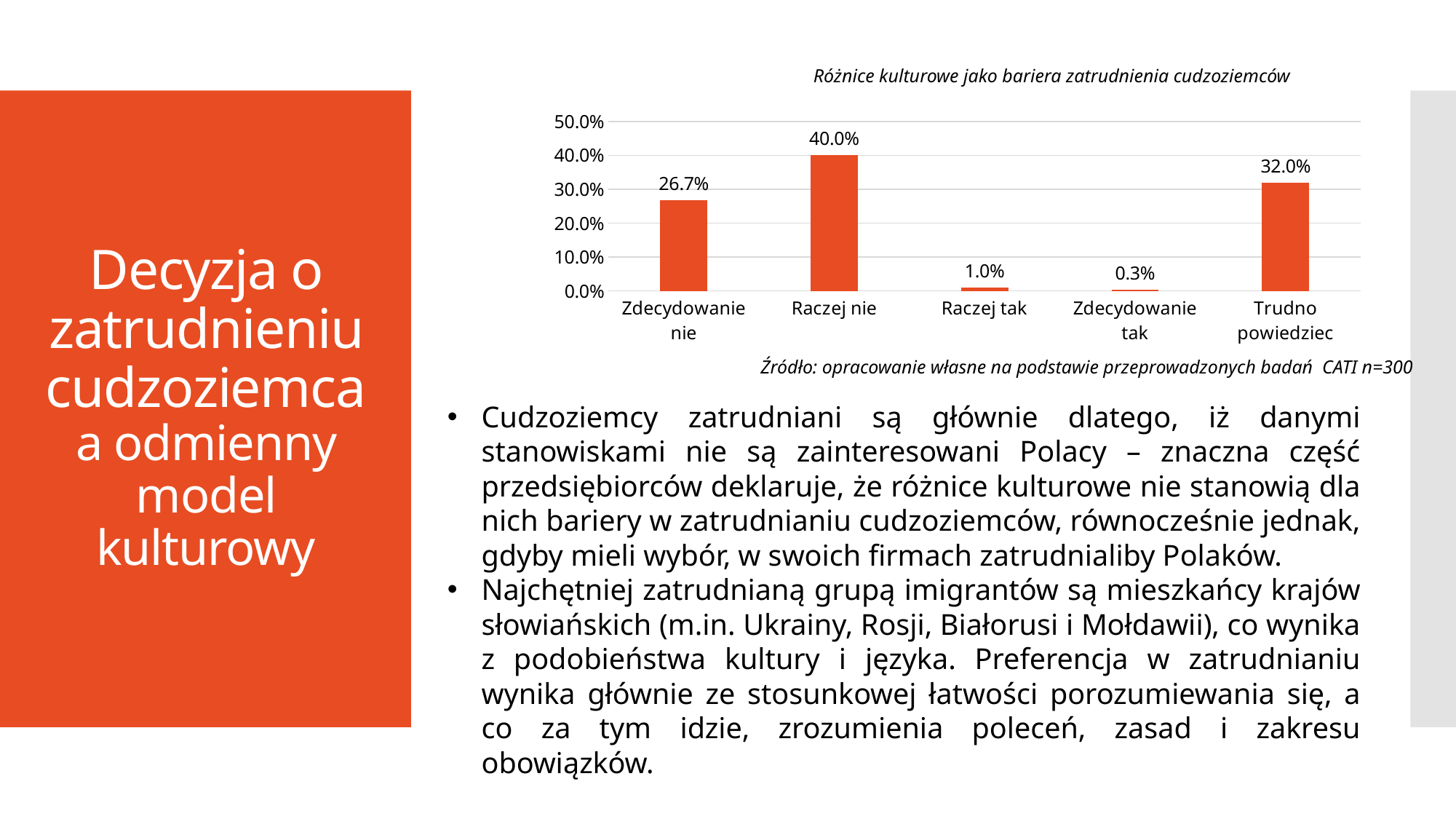
What is the value for "Zdecydowanie tak"? 0.3% What is the difference between the values for "Raczej nie" and "Trudno powiedziec"? 8.0% Which category has the highest value? Raczej nie How many categories are shown on the x axis? 5 Which category has the lowest value? Zdecydowanie tak What is the value for "Trudno powiedziec"? 32.0% What is the title of the chart? Różnice kulturowe jako bariera zatrudnienia cudzoziemców Is the value for "Raczej nie" greater or less than 30.0%? greater What kind of chart is shown on the slide? Bar chart Which is larger, the value for "Zdecydowanie nie" or the value for "Trudno powiedziec"? Trudno powiedziec What is the value for "Raczej nie"? 40.0% What is the value for "Zdecydowanie nie"? 26.7%